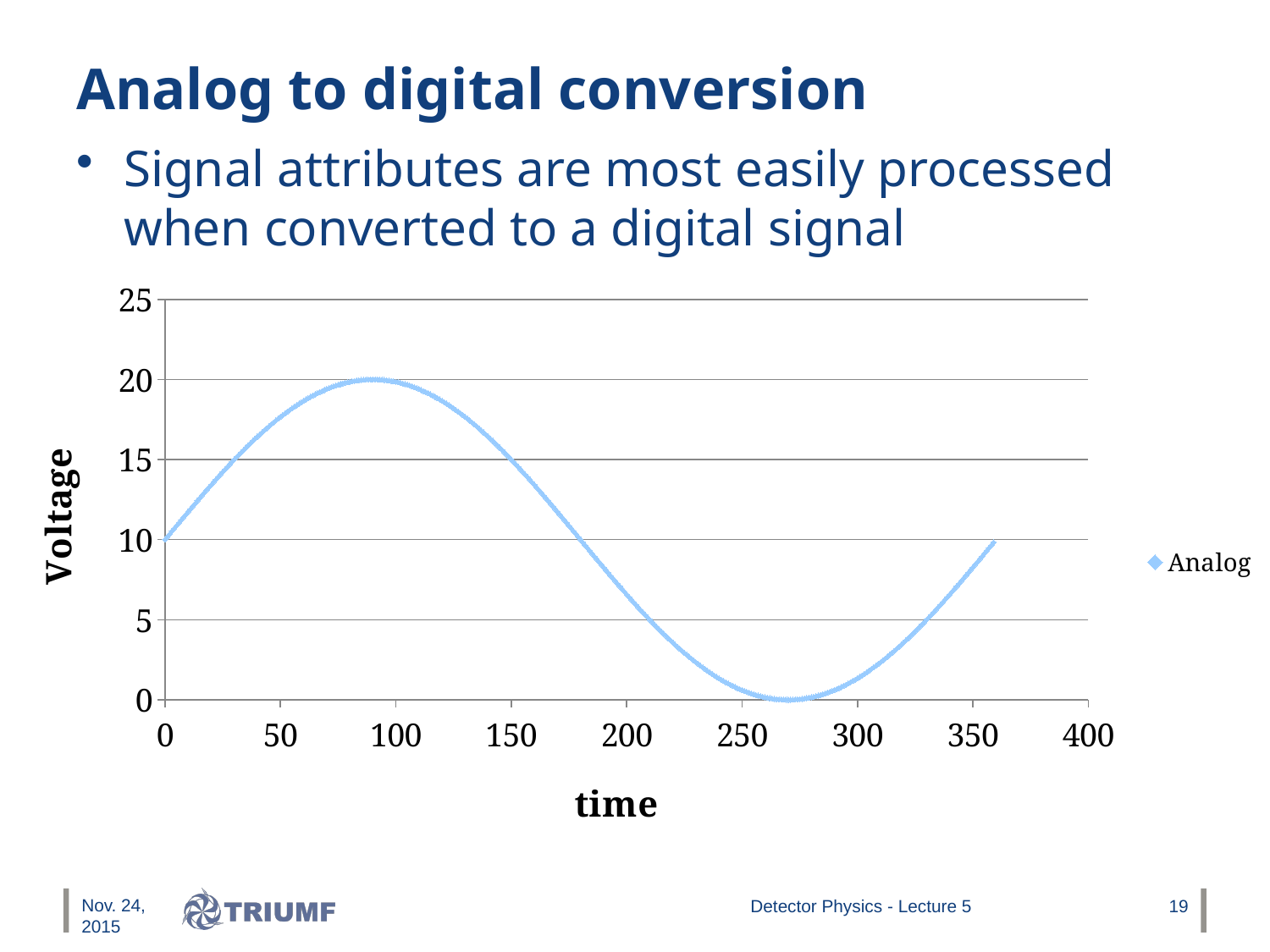
What is the title of the chart's vertical axis? Voltage What kind of chart is shown on the slide? scatter chart Which is larger, the voltage at time 50 or the voltage at time 250? time 50 What is the voltage of the Analog signal at time 0? 10 Is the voltage at time 200 greater or less than 10? less How many series does the chart legend list? 1 What is the lowest voltage reached by the Analog curve? 0 Does the voltage rise or fall as time goes from 100 to 250? fall Is the voltage at time 250 greater or less than 5? less What is the name of the series shown in the chart legend? Analog What is the highest voltage reached by the Analog curve? 20 Is the voltage at time 50 greater or less than 15? greater